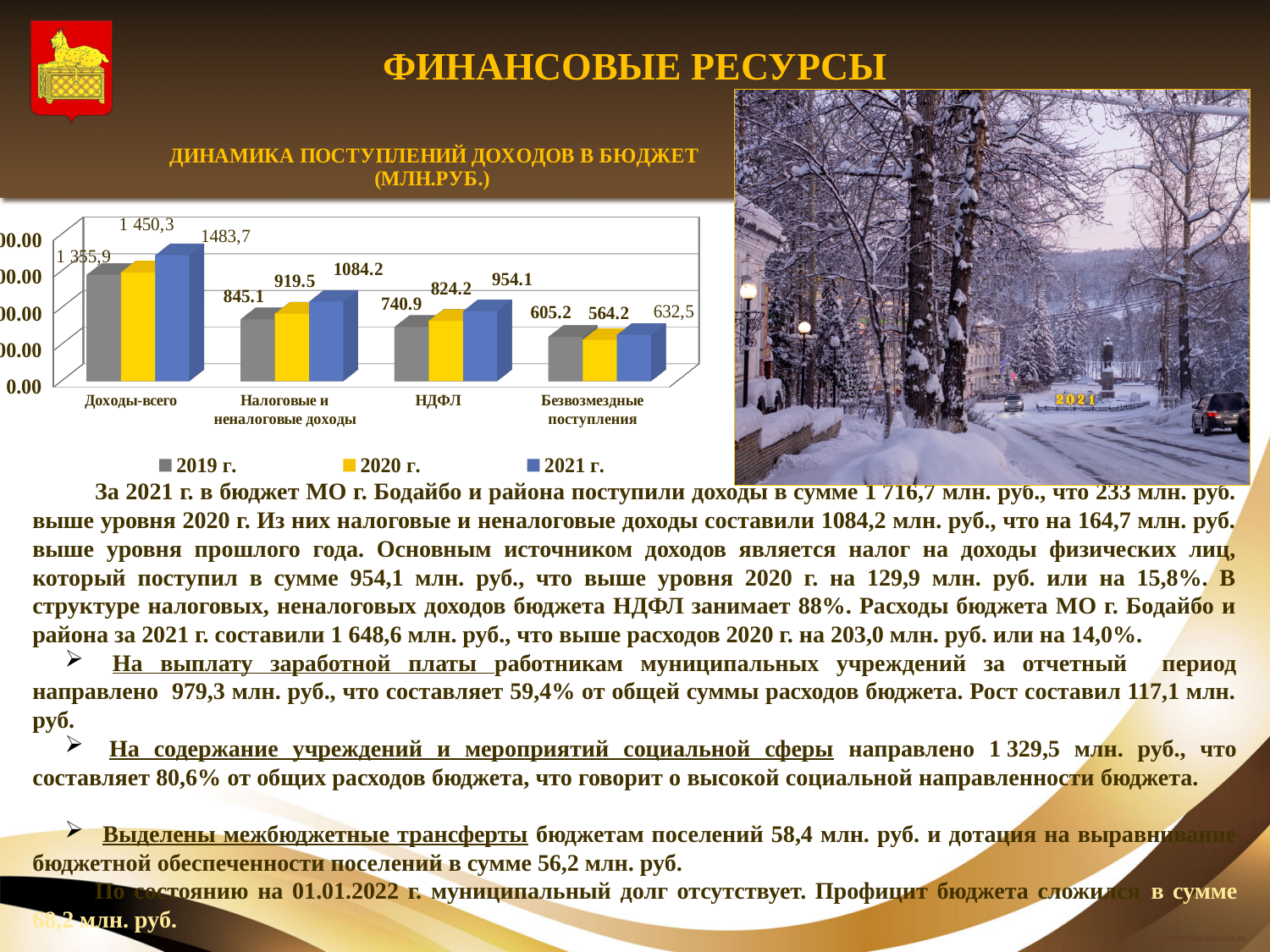
What is the value for Налоговые и неналоговые доходы in 2019 г.? 845.1 What type of chart is shown on the slide? bar chart What is the value for Доходы-всего in 2020 г.? 1 450,3 Do the values for Налоговые и неналоговые доходы rise or fall from 2019 г. to 2021 г.? rise Which is larger for Безвозмездные поступления: the 2019 г. value or the 2020 г. value? 2019 г. Which category has the lowest value for 2021 г.? Безвозмездные поступления What is the value for Безвозмездные поступления in 2020 г.? 564.2 How many categories are shown on the x axis of the chart? 4 Which category has the highest value for 2019 г.? Доходы-всего What is the value for НДФЛ in 2021 г.? 954.1 How many series does the chart legend list? 3 What is the difference between the 2021 г. and 2020 г. values for НДФЛ? 129.9